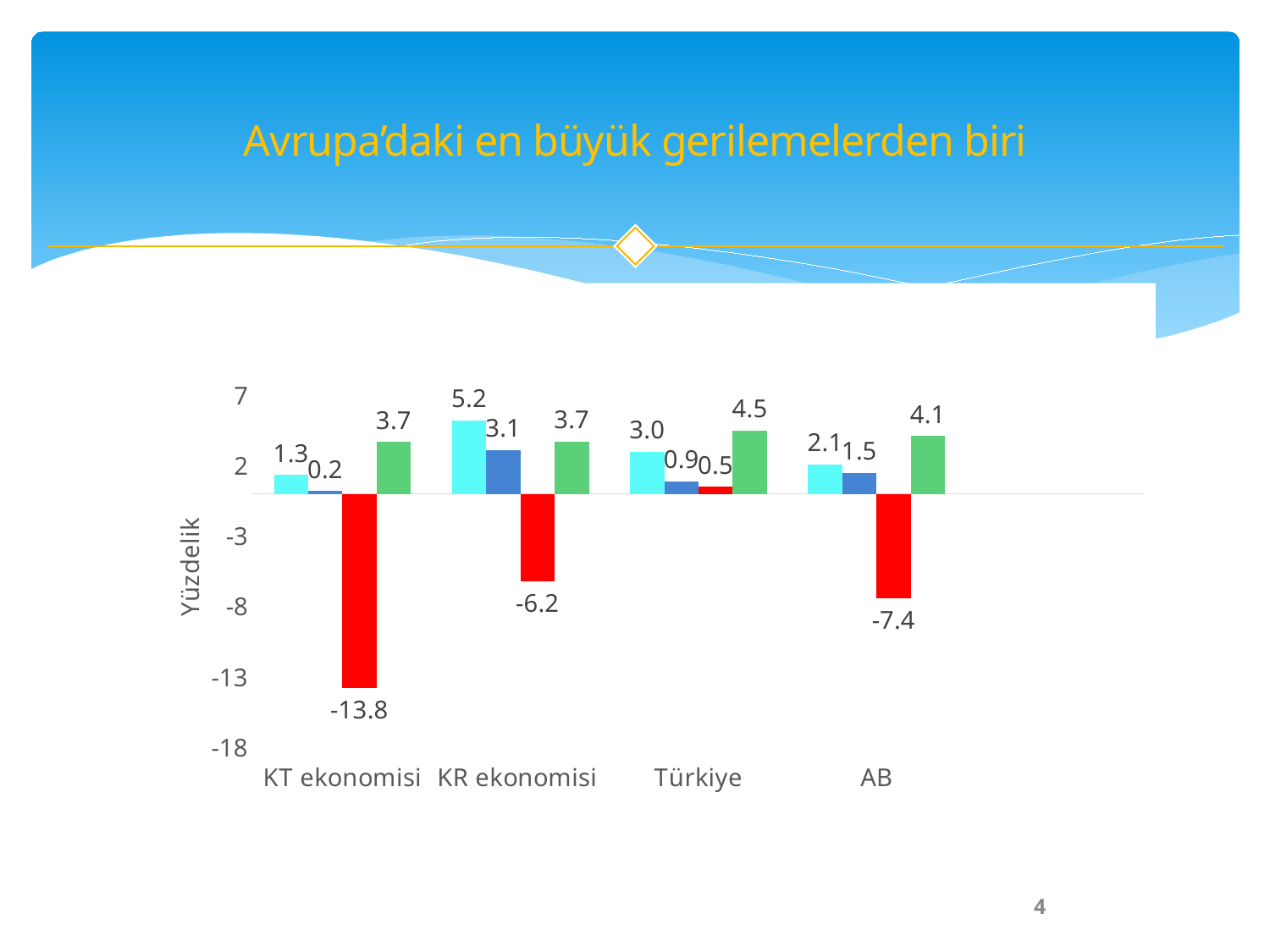
Which category has the highest green bar value? Türkiye What kind of chart is shown on the slide? Bar chart What is the value of the red bar for KT ekonomisi? -13.8 What is the label of the vertical axis? Yüzdelik What is the value of the light blue (cyan) bar for KR ekonomisi? 5.2 Which is larger, the light blue bar for KR ekonomisi or the light blue bar for Türkiye? KR ekonomisi How many bars are shown for each category? 4 What is the value of the green bar for Türkiye? 4.5 How many categories are shown on the x axis? 4 What is the value of the red bar for AB? -7.4 Which category has the lowest red bar value? KT ekonomisi What is the difference between the green bar values for Türkiye (4.5) and AB (4.1)? 0.4